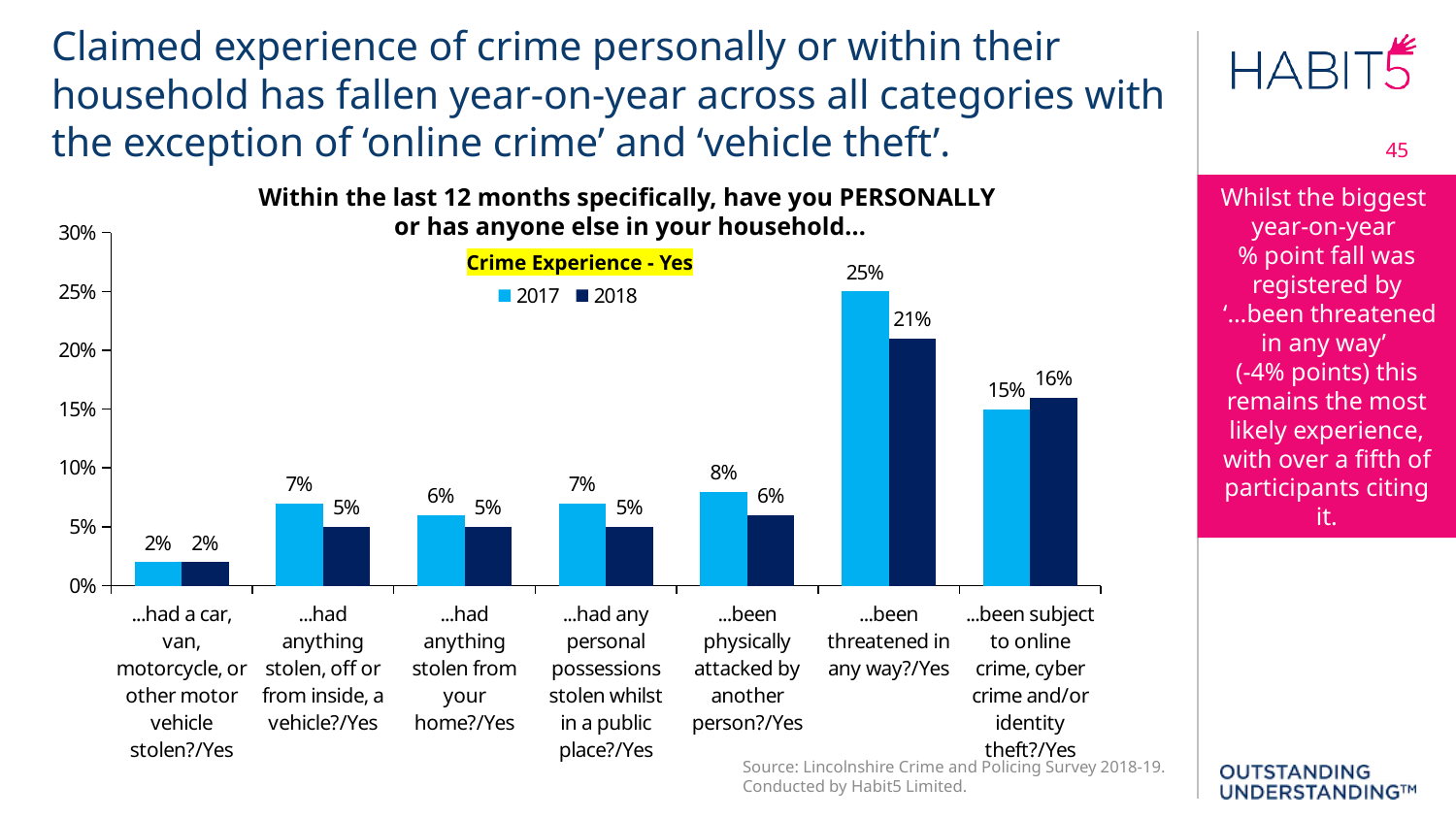
Which category had the lowest 2017 value? ...had a car, van, motorcycle, or other motor vehicle stolen?/Yes What kind of chart is shown on the slide? Bar chart What was the 2018 value for '...been subject to online crime, cyber crime and/or identity theft?/Yes'? 16% For '...had anything stolen from your home?/Yes', which year had the larger value, 2017 or 2018? 2017 What is the difference between the 2017 and 2018 values for '...been threatened in any way?/Yes'? 4% How many series does the chart's legend list? 2 What was the 2017 value for '...been threatened in any way?/Yes'? 25% What are the two series listed in the chart's legend? 2017 and 2018 Which category had the highest 2018 value? ...been threatened in any way?/Yes Is the 2017 value for '...been threatened in any way?/Yes' greater or less than 20%? greater How many categories are shown on the x axis of the chart? 7 What was the 2018 value for '...been physically attacked by another person?/Yes'? 6%